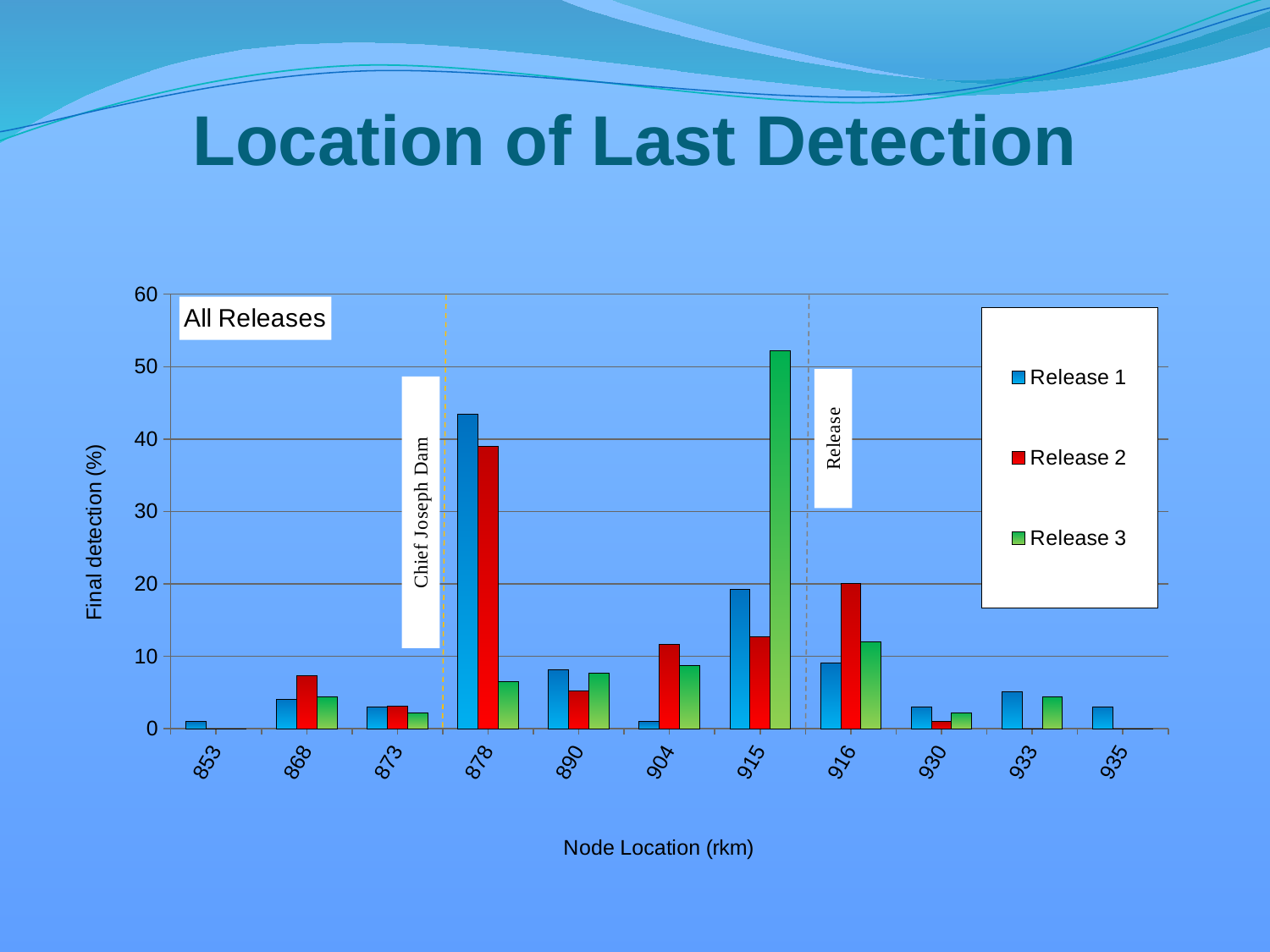
At node 878, which is larger: Release 1 or Release 2? Release 1 How many node locations are shown on the x axis? 11 At which node location does Release 2 reach its highest final detection? 878 At which node location does Release 3 reach its highest final detection? 915 At node 916, which is larger: Release 1 or Release 2? Release 2 Is the value for Release 2 at node 904 greater or less than 10? greater What is the label of the x axis? Node Location (rkm) How many series does the legend list? 3 Is the value for Release 3 at node 915 greater or less than 50? greater At which node location does Release 1 reach its highest final detection? 878 Is the value for Release 1 at node 878 greater or less than 40? greater What kind of chart is shown on the slide? bar chart